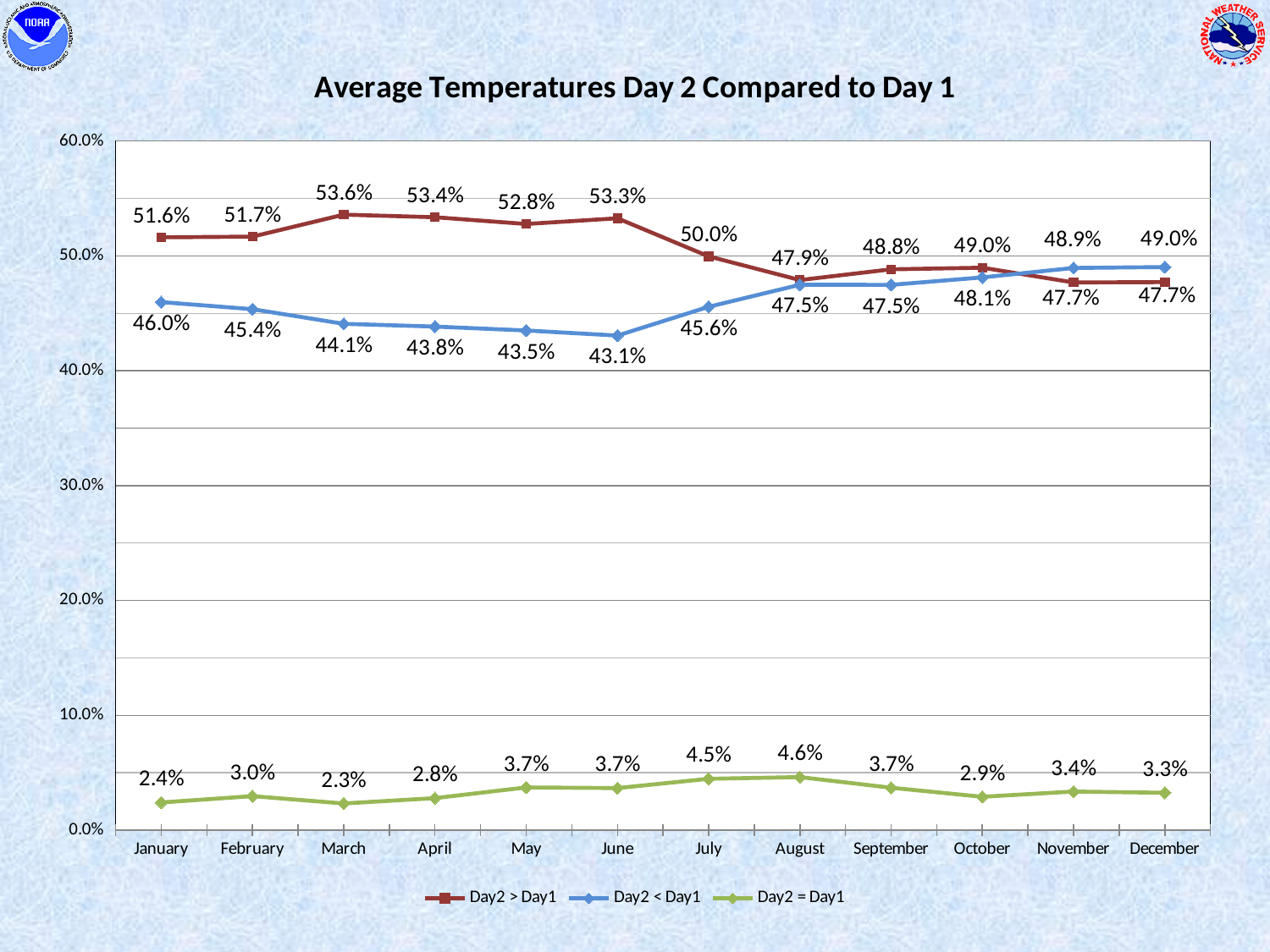
How many series does the legend list? 3 What is the value for Day2 > Day1 in March? 53.6% In which month is the Day2 < Day1 series lowest? June What type of chart is shown on the slide? Line chart How many months are plotted along the x axis? 12 What is the value for Day2 = Day1 in August? 4.6% What is the difference between Day2 > Day1 and Day2 < Day1 in January? 5.6% Which is larger in December, Day2 > Day1 or Day2 < Day1? Day2 < Day1 In which month is the Day2 > Day1 series highest? March Does the Day2 < Day1 series rise or fall from January to June? Fall What is the value for Day2 < Day1 in June? 43.1% What is the title of the chart? Average Temperatures Day 2 Compared to Day 1